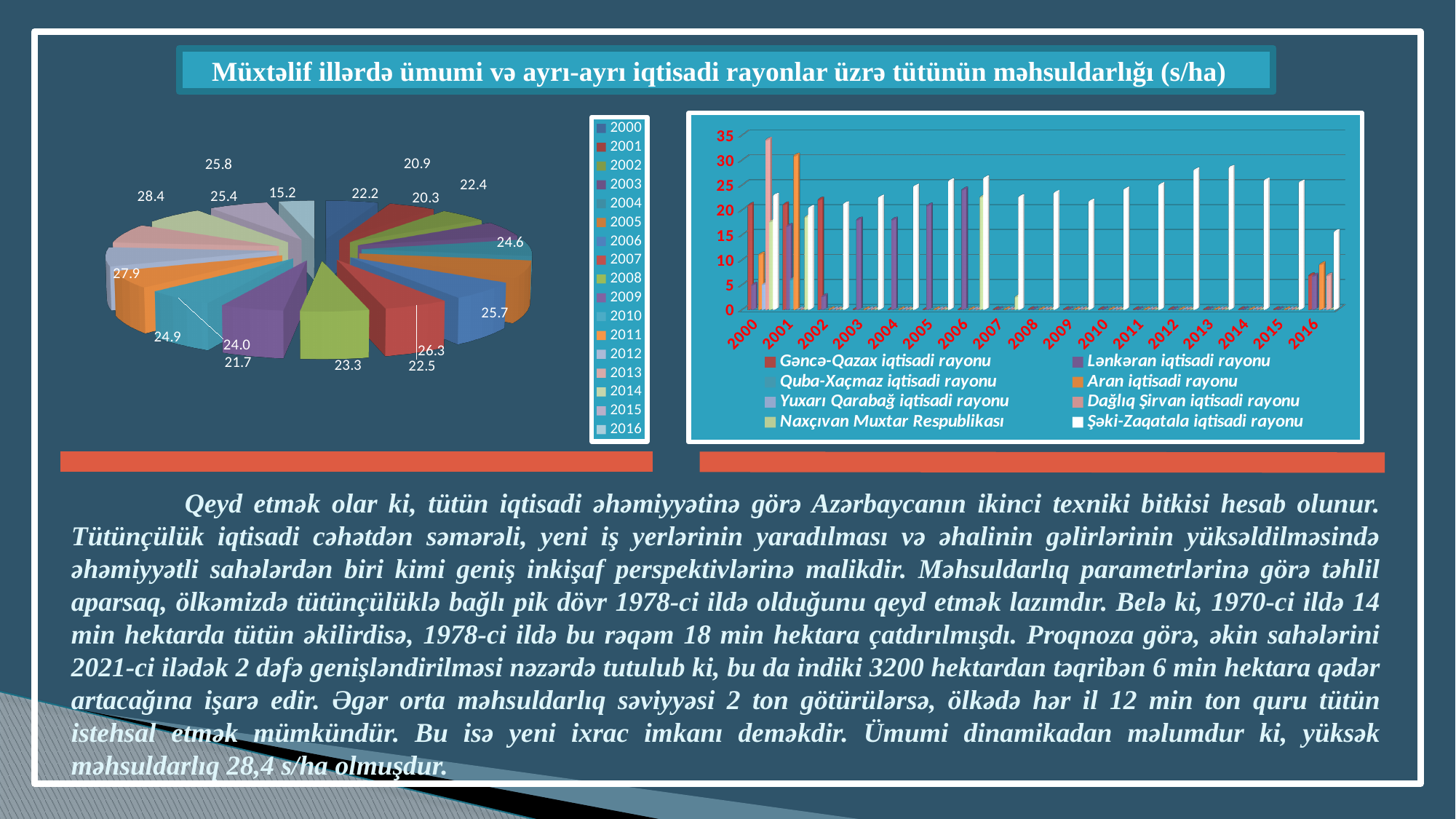
How many series does the legend of the bar chart on the right list? 8 How many entries does the legend of the pie chart on the left list? 17 In the bar chart on the right, which region has the tallest bar in 2000? Dağlıq Şirvan iqtisadi rayonu In the bar chart on the right, is the value for Lənkəran iqtisadi rayonu in 2003 greater or less than 20? less What type of chart is the chart on the left of the slide? pie chart In the pie chart on the left, what is the smallest data label shown? 15.2 In the pie chart on the left, what is the largest data label shown? 28.4 In the bar chart on the right, is the value for Şəki-Zaqatala iqtisadi rayonu in 2013 greater or less than 25? greater In the bar chart on the right, is the value for Şəki-Zaqatala iqtisadi rayonu in 2016 greater or less than 20? less How many years are shown on the x axis of the bar chart on the right? 17 In the bar chart on the right, is the value for Şəki-Zaqatala iqtisadi rayonu larger in 2013 or in 2016? 2013 What type of chart is the chart on the right of the slide? bar chart